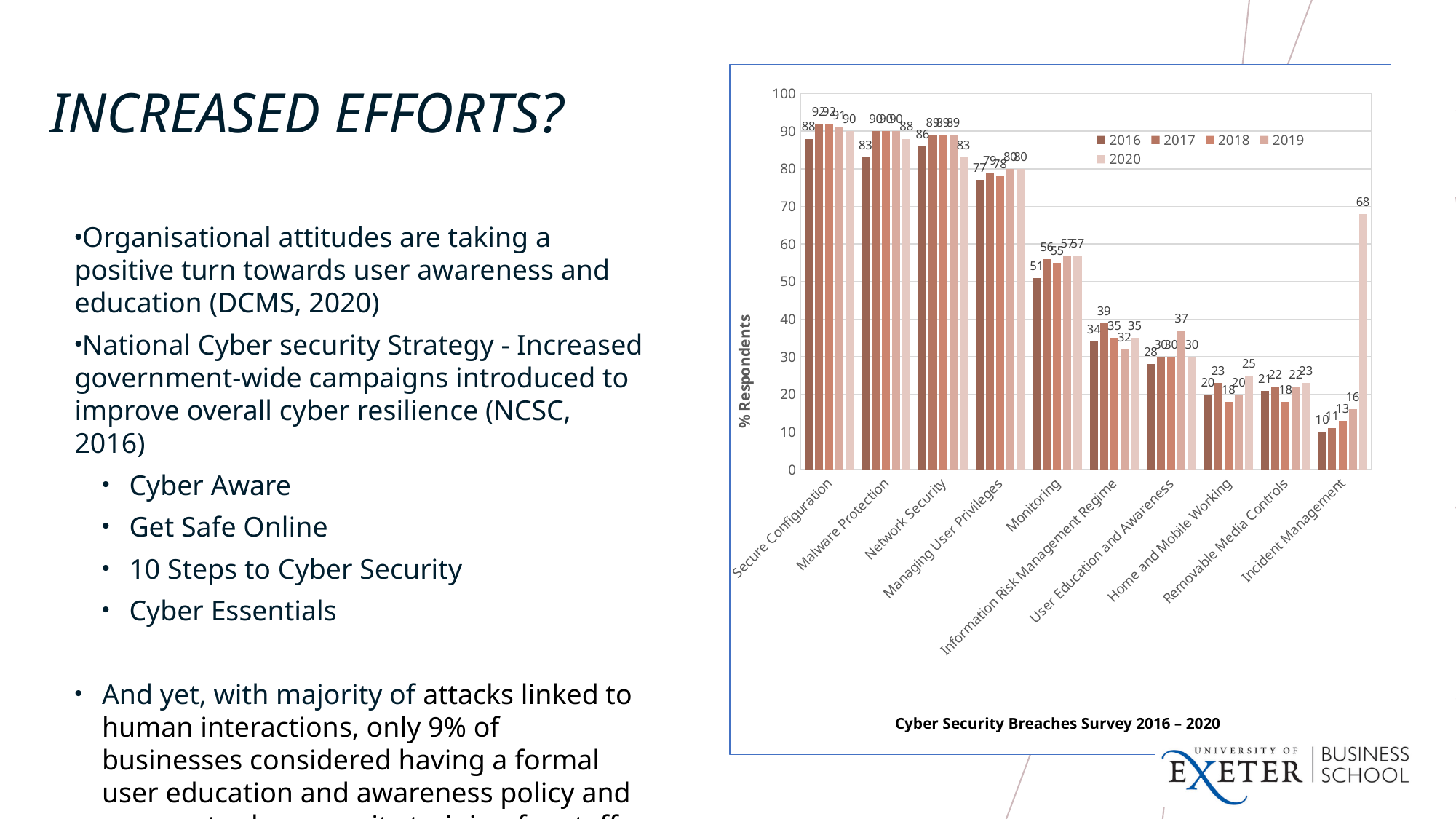
Which category has the lowest 2016 value? Incident Management Which has the larger 2019 value: User Education and Awareness or Information Risk Management Regime? User Education and Awareness What kind of chart is shown on the slide? bar chart Which category has the highest 2020 value? Secure Configuration What is the label on the y axis? % Respondents How many series does the legend list? 5 What is the 2016 value for Secure Configuration? 88 Do the values for Incident Management rise or fall from 2016 to 2020? rise How many categories are shown along the x axis? 10 What is the 2016 value for Monitoring? 51 What is the 2020 value for Incident Management? 68 What is the difference between the 2020 and 2019 values for Incident Management? 52